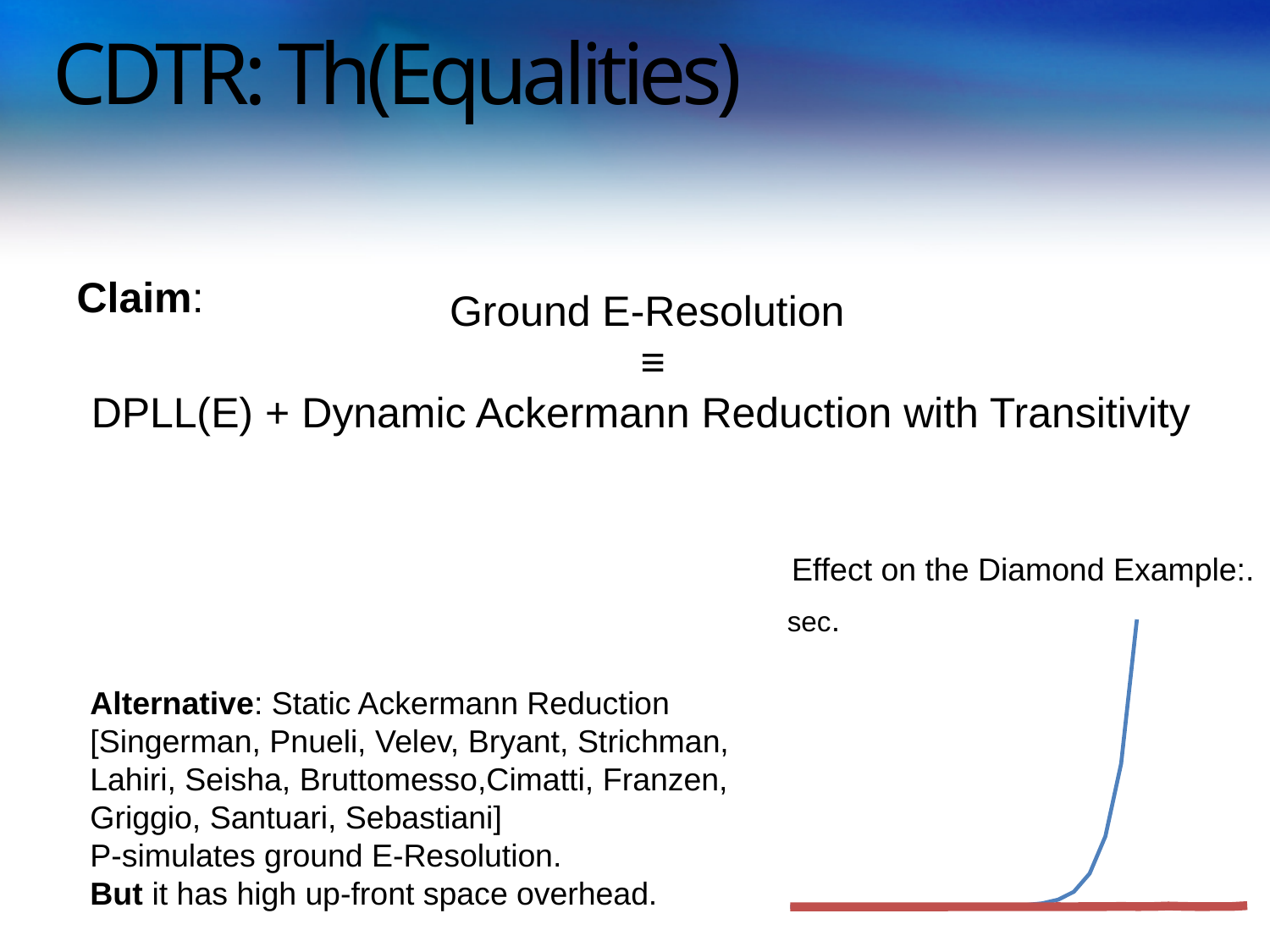
What unit is written on the vertical axis of the chart? sec. What kind of chart is shown on the slide? line chart What is the title of the chart? Effect on the Diamond Example:. How many lines are plotted in the chart? 2 Does the red line rise, fall, or stay flat along the x axis? stay flat Which line reaches the higher value at the right end of the chart, the blue line or the red line? blue line Does the blue line rise or fall as it moves to the right along the x axis? rise